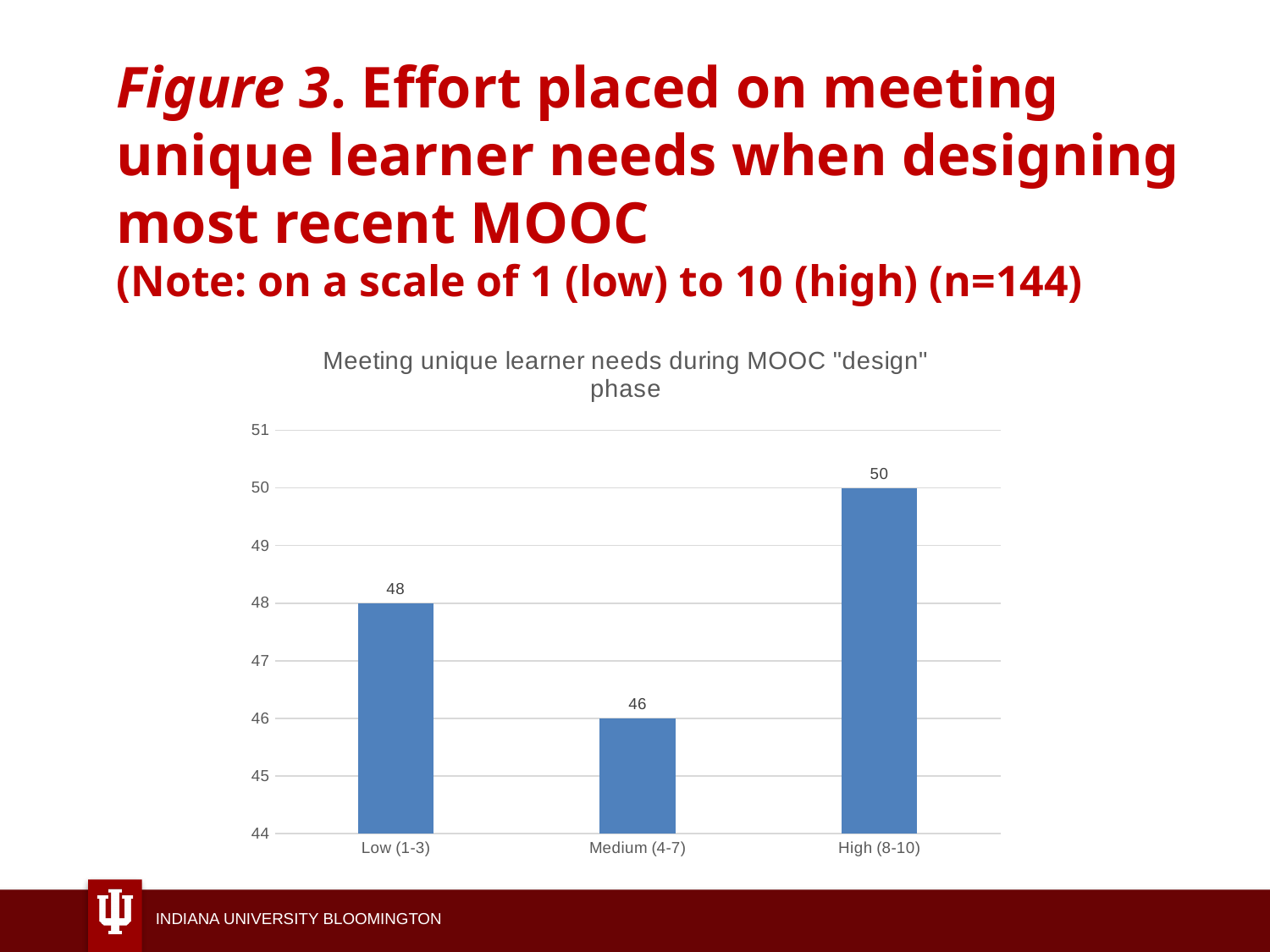
Which category has the lowest value? Medium (4-7) What is the title of the chart? Meeting unique learner needs during MOOC "design" phase How many categories are shown on the x axis? 3 Is the value for Medium (4-7) greater or less than 47? less What is the difference between the values for Low (1-3) and Medium (4-7)? 2 Which category has the highest value? High (8-10) What kind of chart is shown on the slide? bar chart What is the difference between the values for High (8-10) and Medium (4-7)? 4 Which is larger, the value for Low (1-3) or the value for High (8-10)? High (8-10) What is the value for Medium (4-7)? 46 What is the value for High (8-10)? 50 What is the value for Low (1-3)? 48